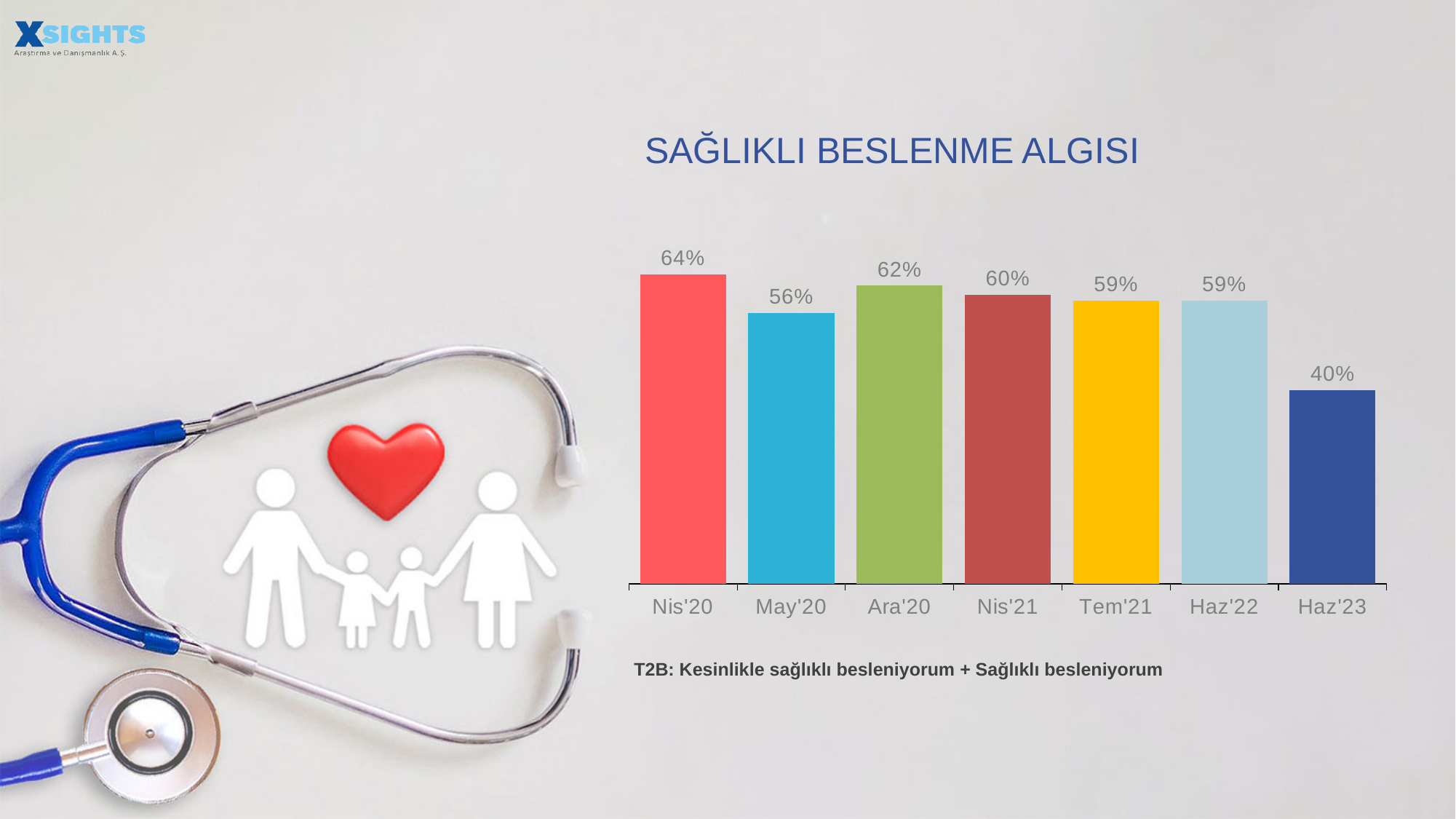
What is the value for Haz'23? 40% Which is larger, the value for Ara'20 or the value for Nis'21? Ara'20 What is the difference between the values for Ara'20 and May'20? 6% What is the title of the chart? SAĞLIKLI BESLENME ALGISI Which period has the lowest value? Haz'23 What kind of chart is shown on the slide? Bar chart How many periods are shown on the x axis? 7 What is the value for May'20? 56% What is the difference between the values for Nis'20 and Haz'23? 24% Do the values rise or fall from Haz'22 to Haz'23? Fall What is the value for Nis'20? 64% Which period has the highest value? Nis'20